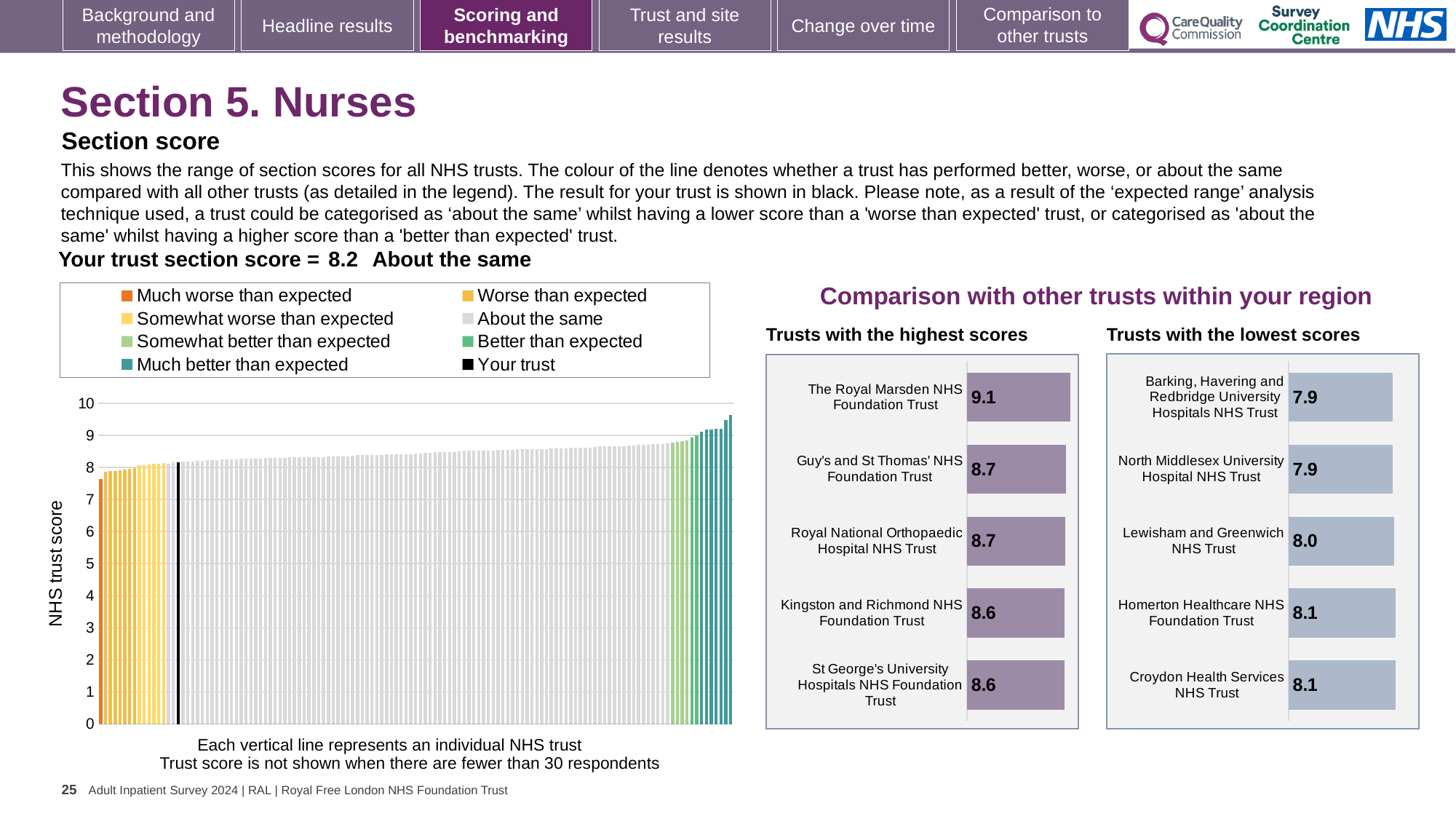
Comparing the 'Trusts with the highest scores' and 'Trusts with the lowest scores' charts, what is the difference between the score of The Royal Marsden NHS Foundation Trust and Barking, Havering and Redbridge University Hospitals NHS Trust? 1.2 How many entries does the legend of the main NHS trust score chart list? 8 In the 'Trusts with the highest scores' chart, what is the score for The Royal Marsden NHS Foundation Trust? 9.1 In the 'Trusts with the highest scores' chart, which trust has the highest score? The Royal Marsden NHS Foundation Trust In the main NHS trust score chart on the left, do the trust scores rise or fall from left to right? Rise In the main NHS trust score chart on the left, what is the section score for your trust? 8.2 In the main NHS trust score chart on the left, is the value of the tallest bar greater or less than 9? greater In the 'Trusts with the highest scores' chart, what is the difference between the scores of The Royal Marsden NHS Foundation Trust and Kingston and Richmond NHS Foundation Trust? 0.5 What kind of chart is the 'Trusts with the highest scores' chart? Bar chart In the 'Trusts with the lowest scores' chart, what is the score for Lewisham and Greenwich NHS Trust? 8.0 In the 'Trusts with the lowest scores' chart, which has the larger score: Lewisham and Greenwich NHS Trust or Homerton Healthcare NHS Foundation Trust? Homerton Healthcare NHS Foundation Trust How many trusts are shown in the 'Trusts with the lowest scores' chart? 5